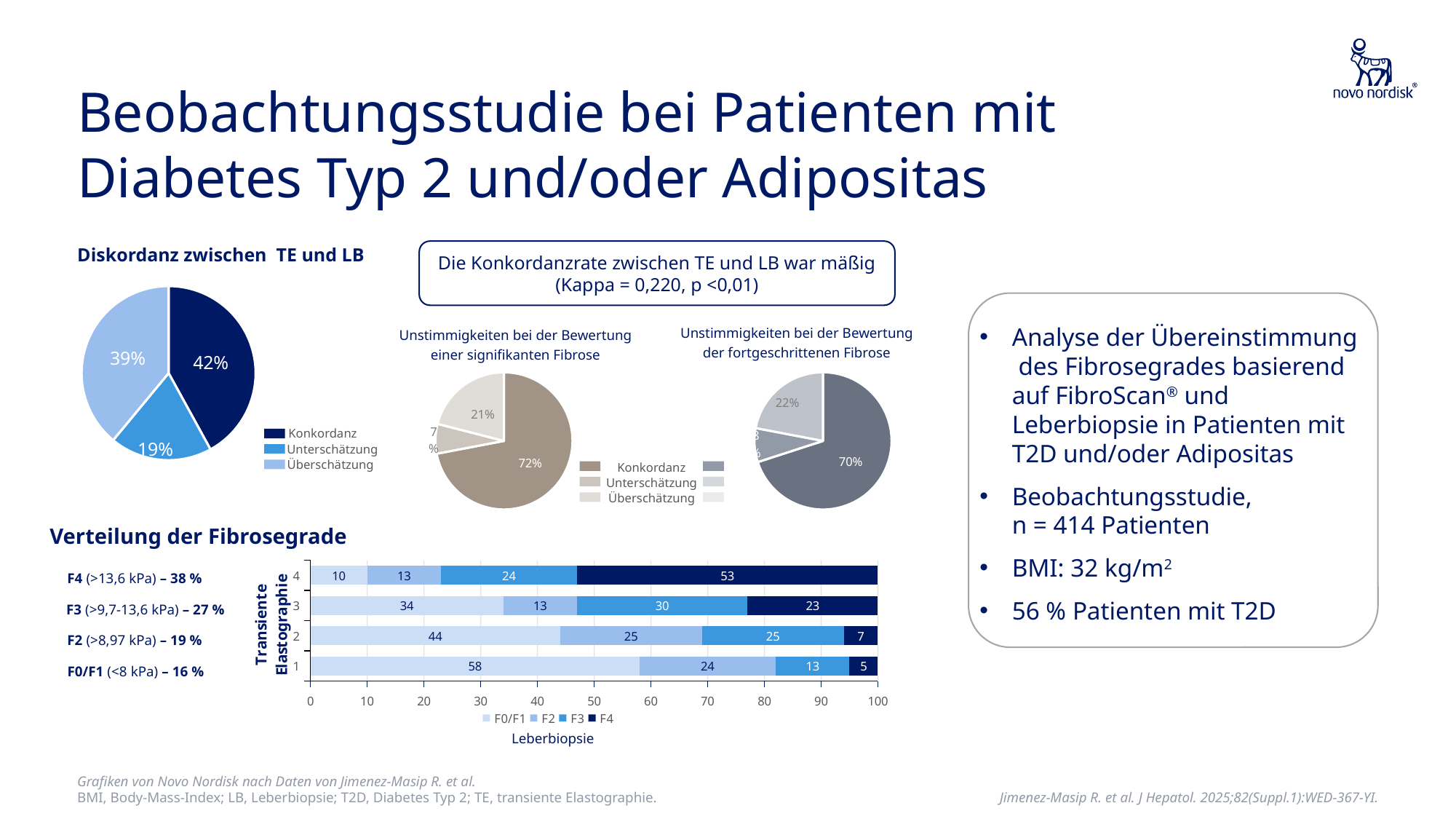
In the pie chart titled 'Diskordanz zwischen TE und LB', what share is labelled for Unterschätzung? 19% In the pie chart 'Unstimmigkeiten bei der Bewertung der fortgeschrittenen Fibrose', what share is labelled for Überschätzung? 22% In the pie chart 'Unstimmigkeiten bei der Bewertung einer signifikanten Fibrose', what share is labelled for Konkordanz? 72% In the pie chart titled 'Diskordanz zwischen TE und LB', which category has the smallest slice? Unterschätzung In the chart 'Verteilung der Fibrosegrade', how many series does the legend list? 4 In the chart 'Verteilung der Fibrosegrade', what is the F4 value for Transiente Elastographie grade 4? 53 In the chart 'Verteilung der Fibrosegrade', what is the difference between the F3 value for grade 3 and the F3 value for grade 1? 17 In the chart 'Verteilung der Fibrosegrade', what is the F0/F1 value for Transiente Elastographie grade 1? 58 What kind of chart is 'Verteilung der Fibrosegrade'? Stacked bar chart